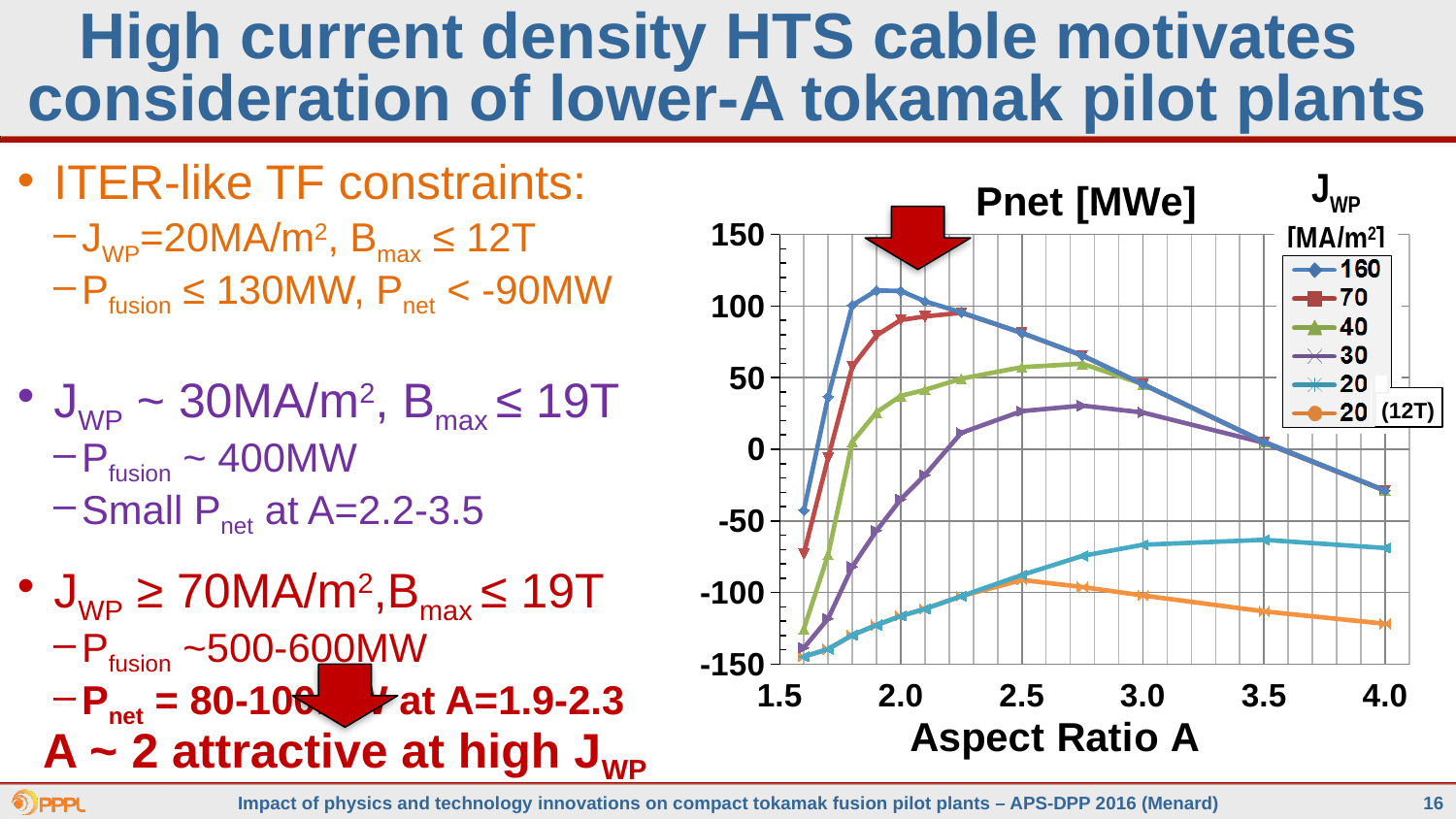
Which J_WP series reaches the highest Pnet value on the chart? 160 Is the Pnet value for the 40 series at A=2.75 greater or less than 50? greater For the 20 series, does Pnet rise or fall as A increases from 1.5 to 3.5? rise What kind of chart is shown on the slide? line chart For the 160 series, does Pnet rise or fall as A increases from 2.0 to 4.0? fall What is the label of the x axis of the chart? Aspect Ratio A At A=2.5, which series has the larger Pnet value, 70 or 40? 70 Is the Pnet value for the 20 (12T) series at A=4.0 greater or less than -100? less How many series does the chart legend list? 6 What is the title of the chart? Pnet [MWe] Is the Pnet value for the 160 series at A=2.0 greater or less than 100? greater Which J_WP series has the lowest Pnet value at A=4.0? 20 (12T)